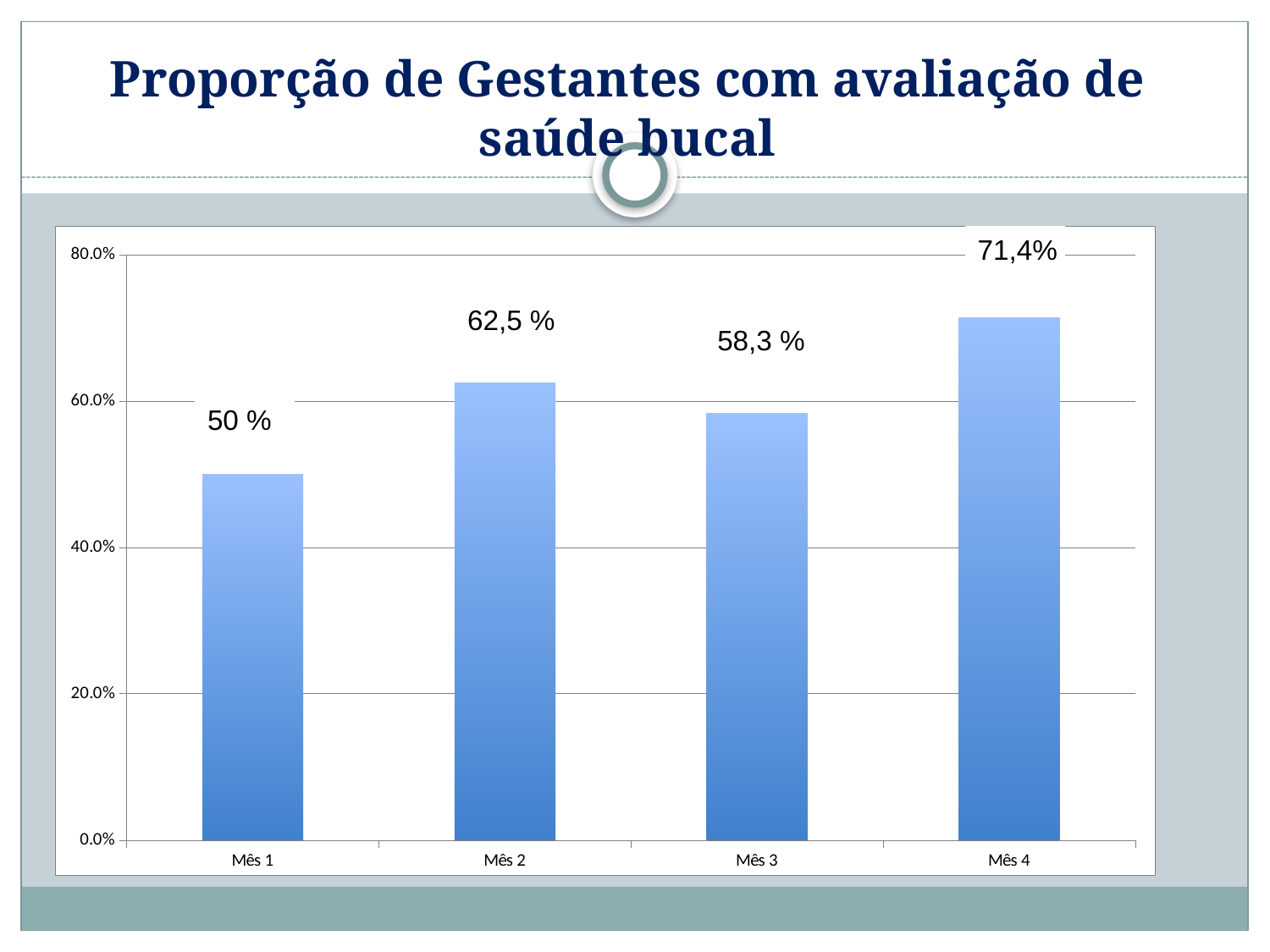
What is the value for Mês 2? 62,5 % Which month has the lowest value? Mês 1 What is the value for Mês 1? 50 % What is the title of the slide? Proporção de Gestantes com avaliação de saúde bucal Is the value for Mês 3 greater or less than 60.0%? less How many months are shown on the x axis? 4 Which is larger, the value for Mês 2 or the value for Mês 3? Mês 2 What is the value for Mês 3? 58,3 % What is the value for Mês 4? 71,4% What is the difference between the values for Mês 4 and Mês 1? 21,4 percentage points What kind of chart is shown on the slide? bar chart Which month has the highest value? Mês 4